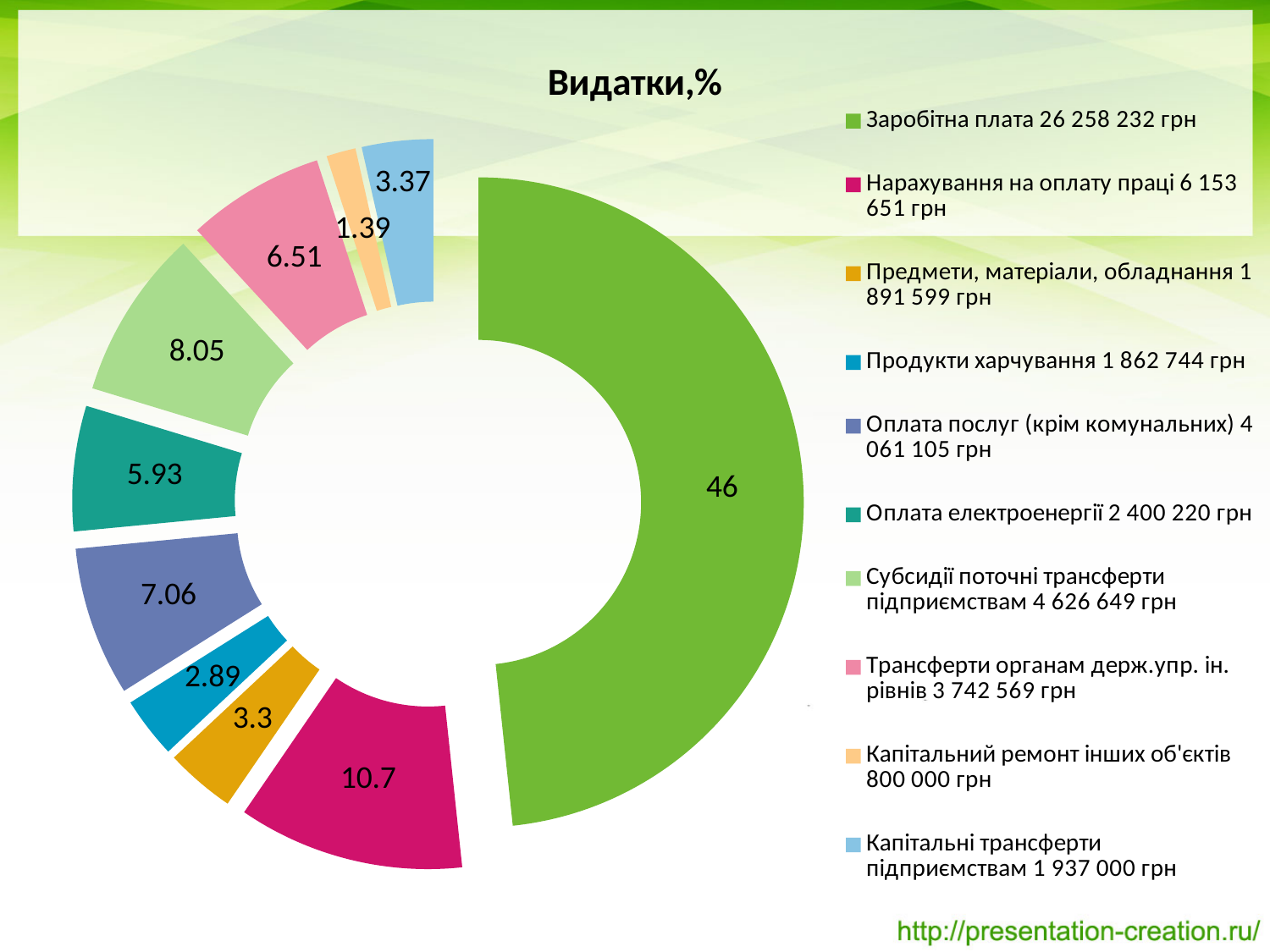
What is the value shown for Нарахування на оплату праці? 10.7 How many slices does the chart have? 10 What kind of chart is shown on the slide? Doughnut (pie) chart How many entries does the legend list? 10 Which is larger, the value for Оплата послуг (крім комунальних) or the value for Оплата електроенергії? Оплата послуг (крім комунальних) What is the value shown for Заробітна плата? 46 What is the difference between the values for Заробітна плата and Нарахування на оплату праці? 35.3 What is the value shown for Субсидії поточні трансферти підприємствам? 8.05 What is the title of the chart? Видатки,% What is the value shown for Капітальний ремонт інших об'єктів? 1.39 Which category has the largest slice? Заробітна плата Which category has the smallest slice? Капітальний ремонт інших об'єктів